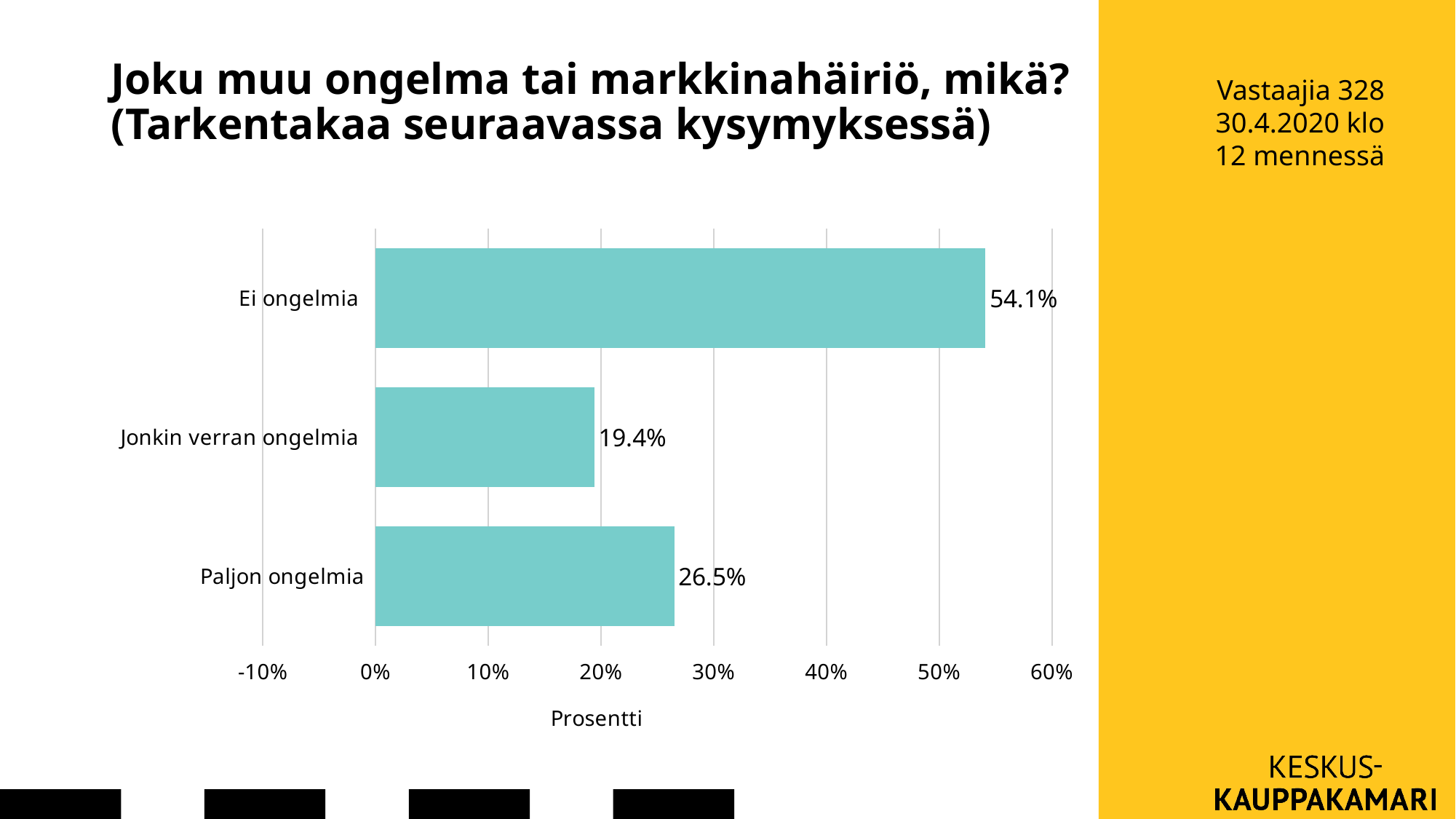
What is the value for Paljon ongelmia? 26.5% Is the value for Ei ongelmia greater or less than 50%? greater Which category has the lowest value? Jonkin verran ongelmia What is the value for Jonkin verran ongelmia? 19.4% Which category has the highest value? Ei ongelmia What kind of chart is shown on the slide? bar chart What is the difference between the values for Ei ongelmia and Paljon ongelmia? 27.6% Which is larger, the value for Paljon ongelmia or the value for Jonkin verran ongelmia? Paljon ongelmia What is the value for Ei ongelmia? 54.1% How many categories are shown in the chart? 3 What is the label of the horizontal axis? Prosentti What is the difference between the values for Paljon ongelmia and Jonkin verran ongelmia? 7.1%